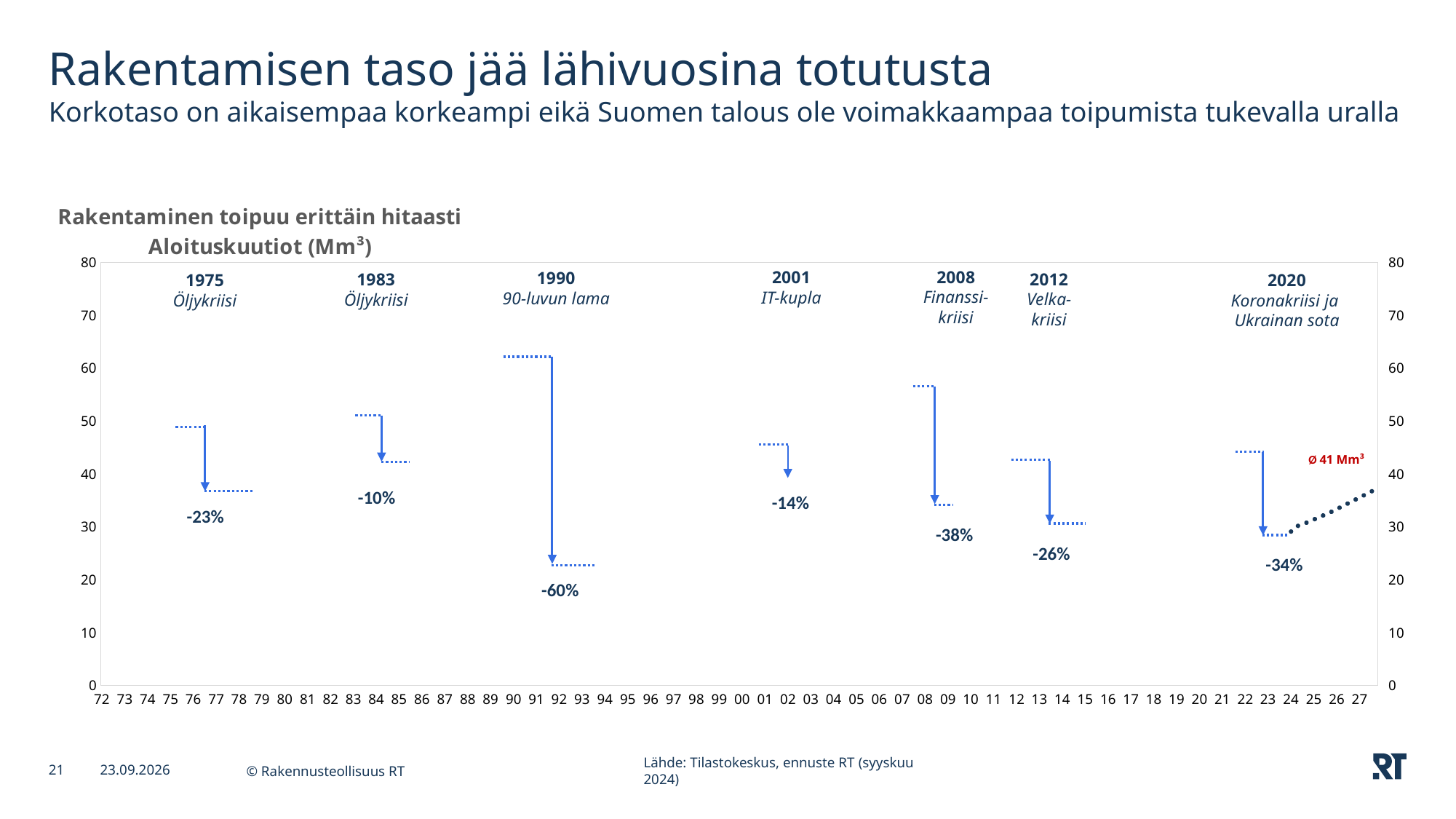
What percentage drop is shown for the 2020 Koronakriisi ja Ukrainan sota? -34% What percentage drop is shown for the 1990 crisis (90-luvun lama)? -60% What percentage drop is shown for the 2008 Finanssikriisi? -38% What average level (Ø) is marked in red on the right side of the chart? Ø 41 Mm³ Is the level after the 2012 drop greater or less than 40? less How many crisis periods are labelled in the chart? 7 Which crisis had a larger percentage drop, 2001 IT-kupla or 2012 Velkakriisi? 2012 Velkakriisi What percentage drop is shown for the 1975 Öljykriisi? -23% Is the level before the 1990 drop greater or less than 50? greater How many percentage points larger is the 1990 drop (-60%) than the 1983 drop (-10%)? 50 percentage points Which crisis shows the largest percentage drop in the chart? 1990 (90-luvun lama) Which crisis shows the smallest percentage drop in the chart? 1983 (Öljykriisi)